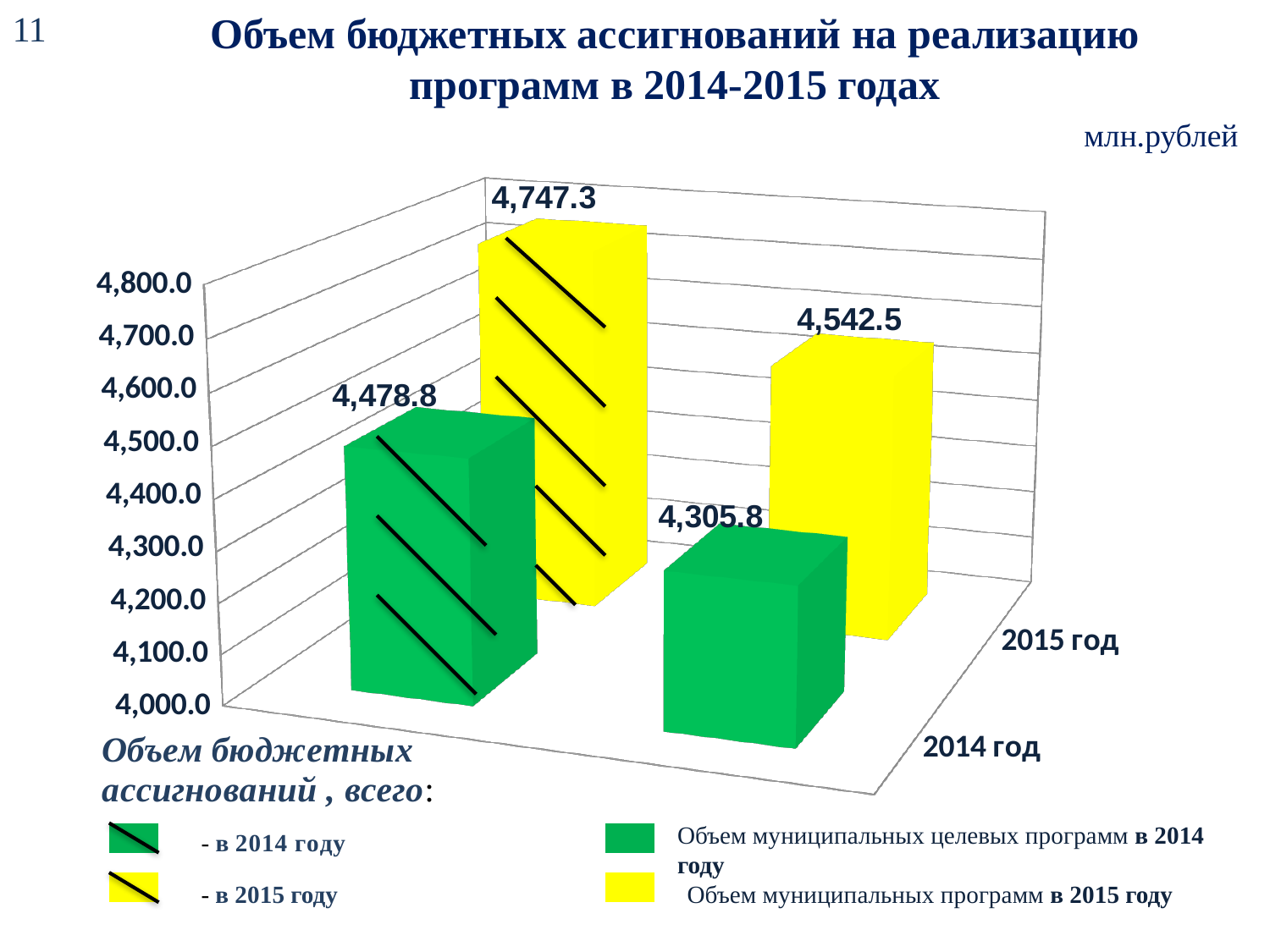
What type of chart is shown on the slide? Bar chart What is the value for Объем муниципальных целевых программ в 2014 году? 4,305.8 What is the difference between the volume of municipal programs in 2015 and in 2014? 236.7 In what units are the values on the chart expressed? млн.рублей Which bar has the lowest value on the chart? Объем муниципальных целевых программ в 2014 году (4,305.8) By how much did the total volume of budget allocations increase from 2014 to 2015? 268.5 What is the total volume of budget allocations in 2014 (Объем бюджетных ассигнований, всего - в 2014 году)? 4,478.8 What is the value for Объем муниципальных программ в 2015 году? 4,542.5 Which bar has the highest value on the chart? Объем бюджетных ассигнований, всего в 2015 году (4,747.3) Did the total volume of budget allocations rise or fall from 2014 to 2015? Rise What is the total volume of budget allocations in 2015 (Объем бюджетных ассигнований, всего - в 2015 году)? 4,747.3 Which is larger: the total budget allocations in 2014 or the volume of municipal programs in 2015? Volume of municipal programs in 2015 (4,542.5)